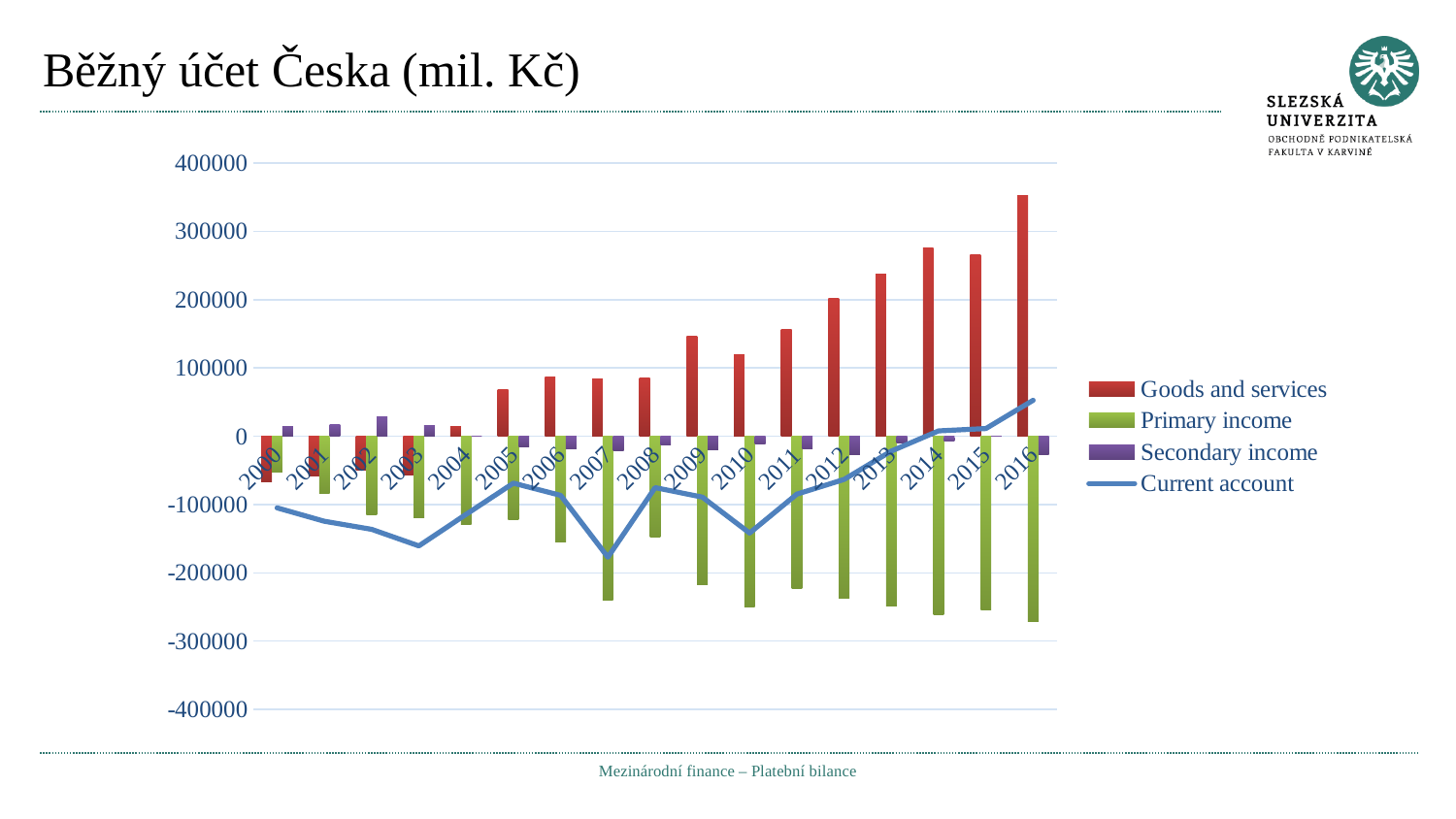
In which year is the Goods and services value highest? 2016 What is the title of the chart slide? Běžný účet Česka (mil. Kč) Is the Current account value for 2016 greater or less than 0? greater How many years are shown on the x axis of the chart? 17 What kind of chart is used to plot the Goods and services, Primary income and Secondary income series? bar chart How many series does the legend list? 4 Is the Primary income value for 2016 greater or less than -200000? less Is the Goods and services value for 2016 greater or less than 300000? greater How is the Current account series drawn on the chart? as a line Which year has the larger Goods and services value, 2009 or 2010? 2009 In which year does the Current account line reach its lowest point? 2007 Does the Goods and services series generally rise or fall from 2000 to 2016? rise